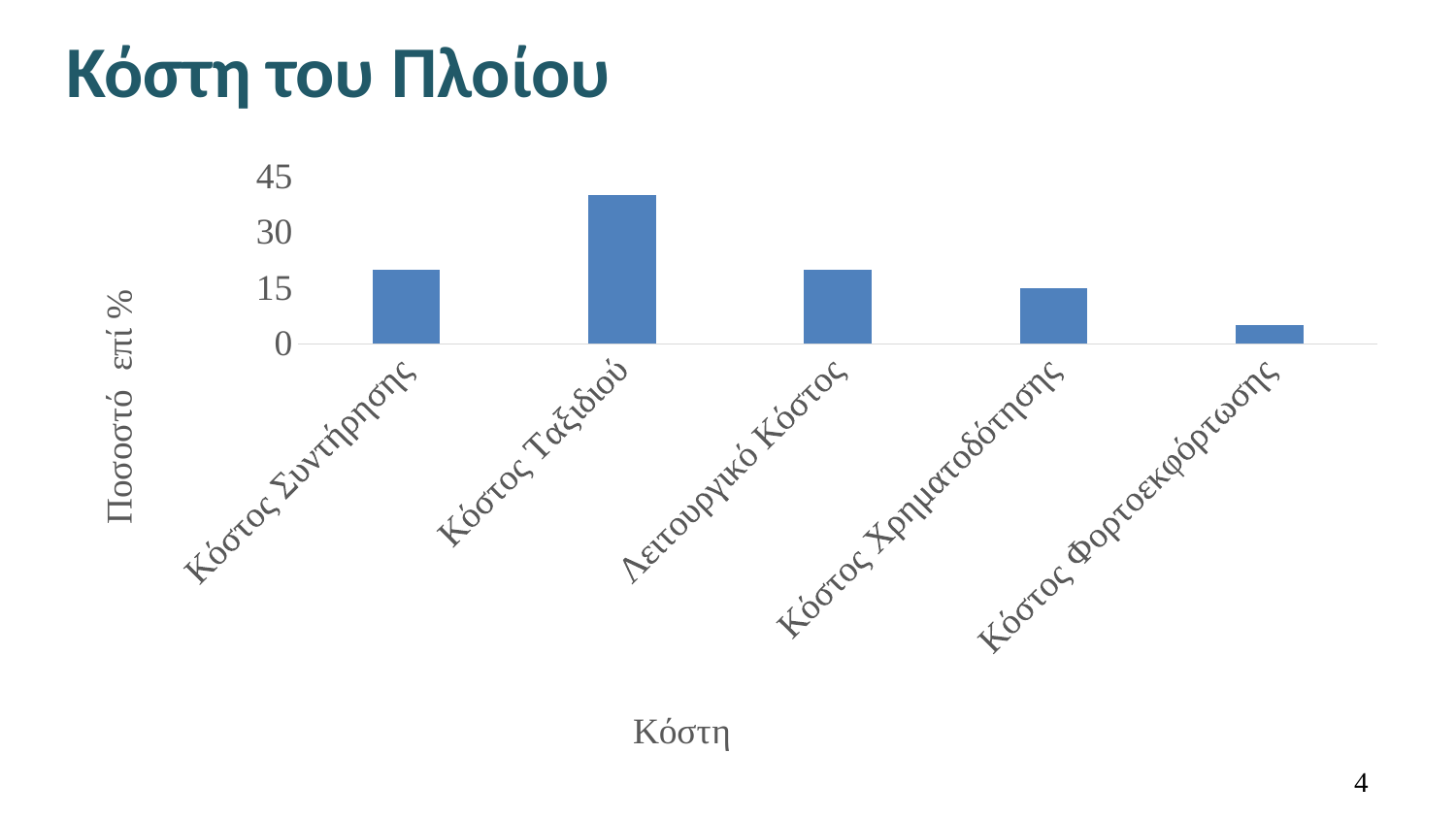
Which is larger, the value for Κόστος Ταξιδιού or the value for Κόστος Συντήρησης? Κόστος Ταξιδιού Which cost category has the lowest value? Κόστος Φορτοεκφόρτωσης What is the title of the horizontal axis of the chart? Κόστη Is the value for Κόστος Ταξιδιού greater or less than 30? greater Is the value for Λειτουργικό Κόστος greater or less than 30? less Is the value for Κόστος Φορτοεκφόρτωσης greater or less than 15? less What is the title of the vertical axis of the chart? Ποσοστό επί % Which cost category has the highest value? Κόστος Ταξιδιού Which is larger, the value for Κόστος Χρηματοδότησης or the value for Κόστος Φορτοεκφόρτωσης? Κόστος Χρηματοδότησης How many cost categories are plotted in the chart? 5 What kind of chart is shown on the slide? bar chart